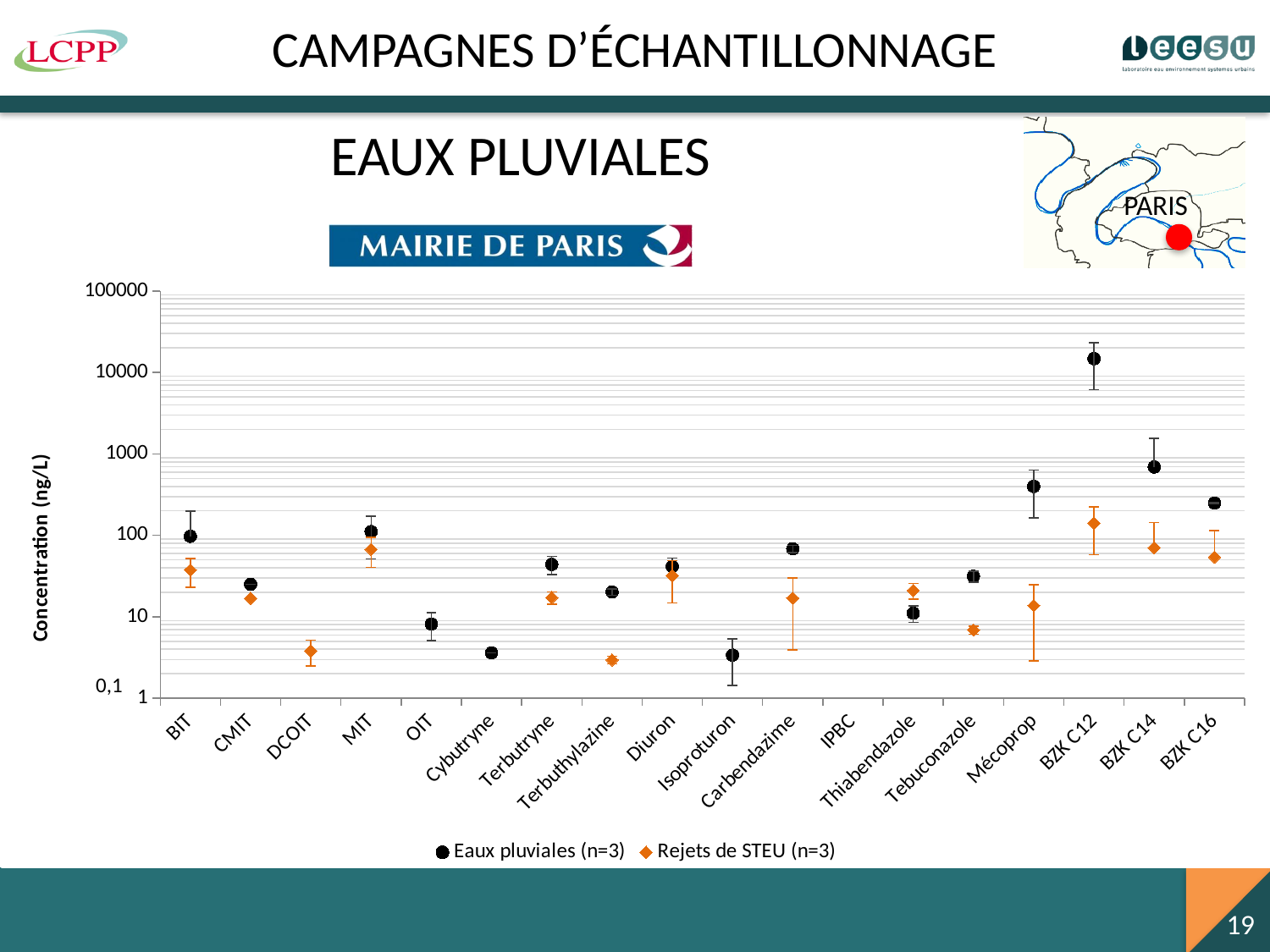
Is the Eaux pluviales (n=3) value for Cybutryne greater or less than 10? less What is the label of the y axis? Concentration (ng/L) Which category has the highest Eaux pluviales (n=3) concentration? BZK C12 Which category has the highest Rejets de STEU (n=3) concentration? BZK C12 How many compound categories are shown along the x axis? 18 For Thiabendazole, which series has the larger value: Eaux pluviales (n=3) or Rejets de STEU (n=3)? Rejets de STEU (n=3) Is the Eaux pluviales (n=3) value for BZK C12 greater or less than 10000? greater Is the Rejets de STEU (n=3) value for DCOIT greater or less than 10? less How many series does the legend list? 2 For BZK C12, which series has the larger value: Eaux pluviales (n=3) or Rejets de STEU (n=3)? Eaux pluviales (n=3) What kind of chart is shown on the slide? Scatter (point) chart with error bars